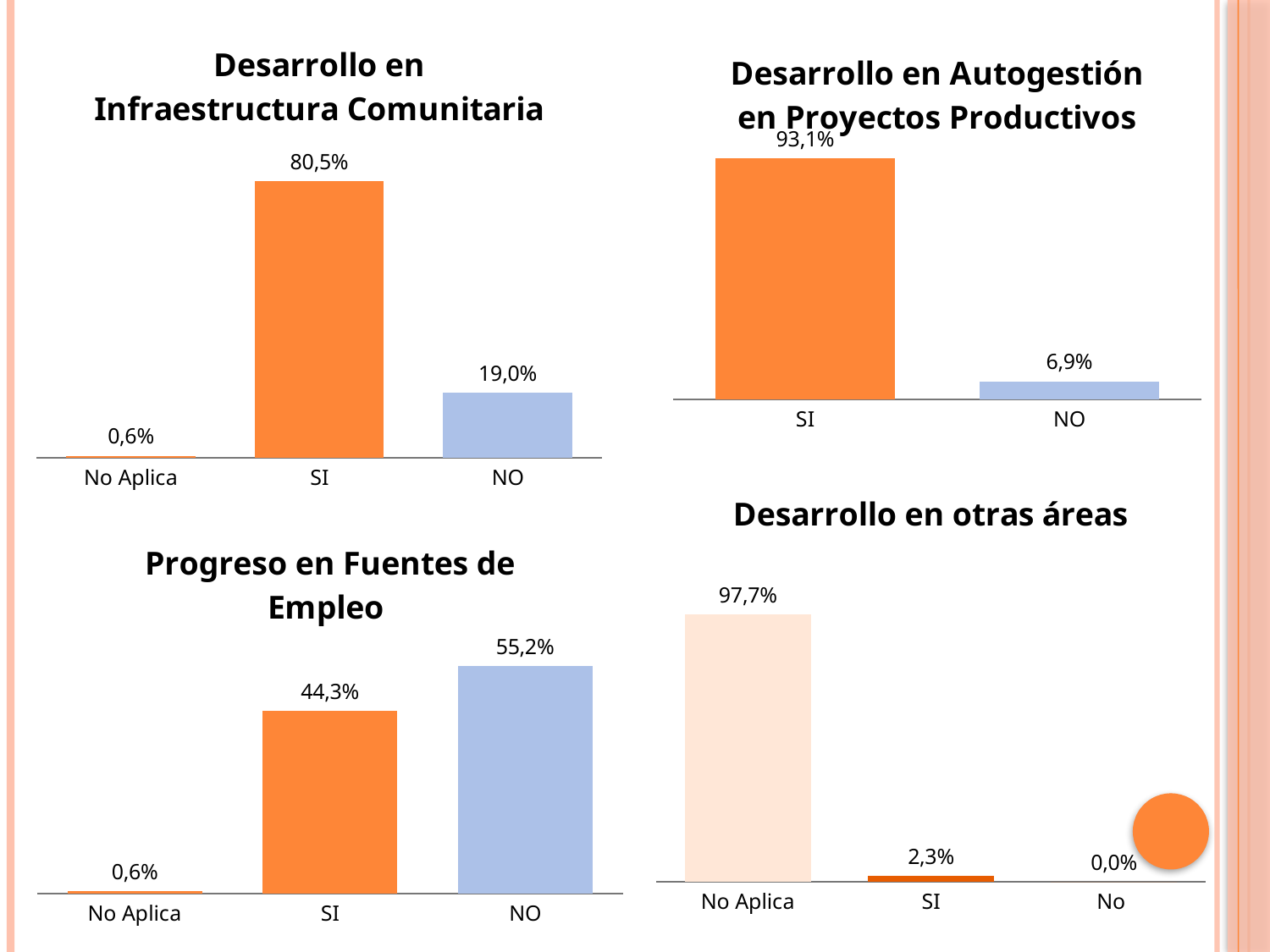
In the 'Desarrollo en Infraestructura Comunitaria' chart, what is the value for SI? 80,5% In the 'Desarrollo en Infraestructura Comunitaria' chart, what is the value for NO? 19,0% In the 'Progreso en Fuentes de Empleo' chart, what is the difference between NO and SI? 10,9% In the 'Desarrollo en otras áreas' chart, what is the value for SI? 2,3% What type of chart is 'Desarrollo en otras áreas'? Bar chart In the 'Desarrollo en Autogestión en Proyectos Productivos' chart, what is the difference between SI and NO? 86,2% How many categories does the 'Desarrollo en Autogestión en Proyectos Productivos' chart show? 2 In the 'Desarrollo en Autogestión en Proyectos Productivos' chart, what is the value for SI? 93,1% In the 'Progreso en Fuentes de Empleo' chart, what is the value for NO? 55,2% In the 'Desarrollo en Infraestructura Comunitaria' chart, which category has the lowest value? No Aplica In the 'Desarrollo en otras áreas' chart, what is the value for No Aplica? 97,7% In the 'Progreso en Fuentes de Empleo' chart, which is larger, SI or NO? NO